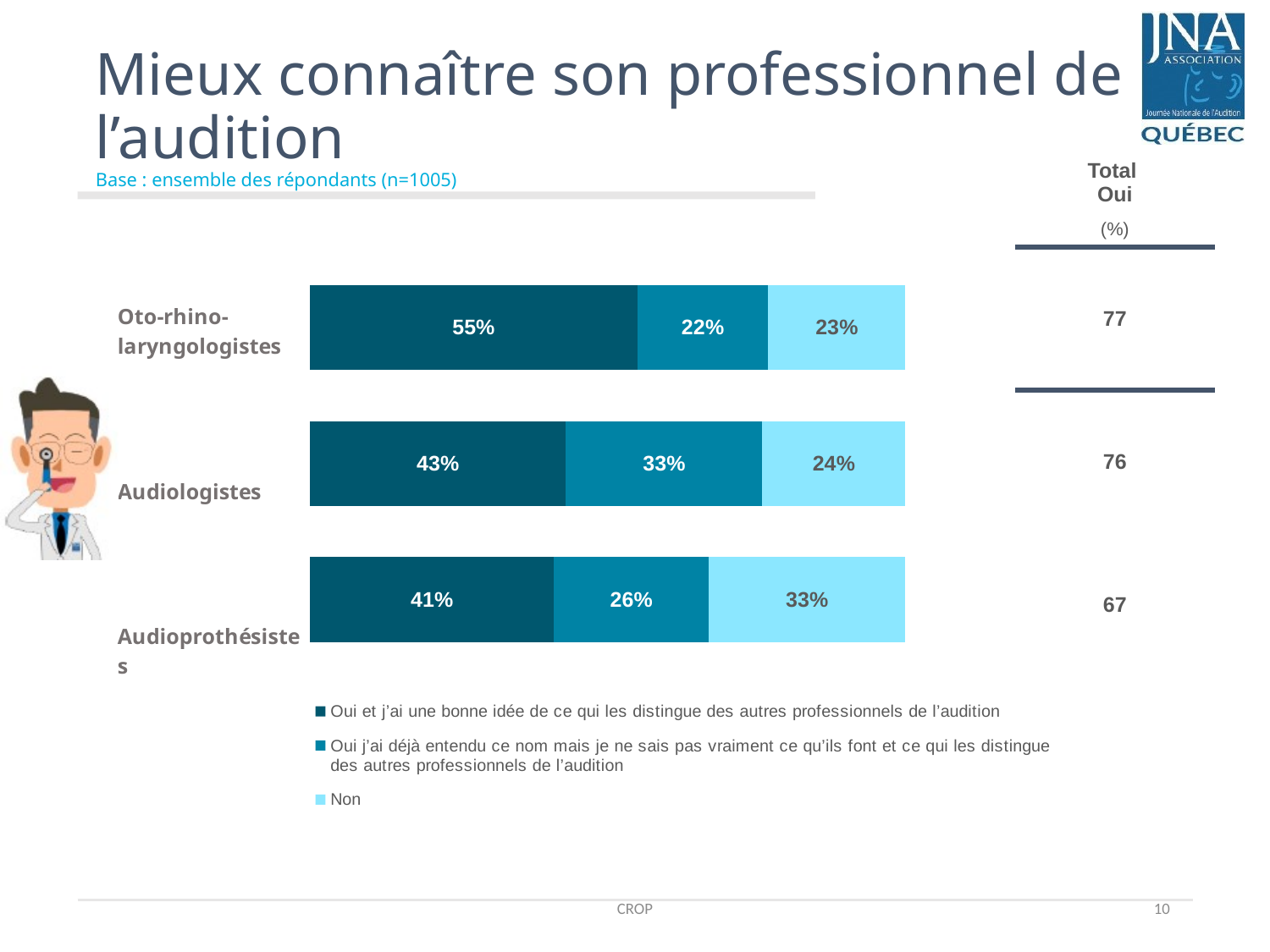
Which is larger: the "Oui j'ai déjà entendu ce nom..." share for Audiologistes or for Oto-rhino-laryngologistes? Audiologistes What percentage of respondents answered "Non" for Audiologistes? 24% What is the difference between the "Non" share for Audioprothésistes and for Oto-rhino-laryngologistes? 10 percentage points What is the "Total Oui" value shown for Audiologistes? 76 How many series does the legend list? 3 What percentage of respondents said "Oui et j'ai une bonne idée de ce qui les distingue des autres professionnels de l'audition" for Oto-rhino-laryngologistes? 55% What percentage of respondents answered "Oui j'ai déjà entendu ce nom mais je ne sais pas vraiment ce qu'ils font..." for Audioprothésistes? 26% What kind of chart is shown on the slide? Stacked bar chart Which professional category has the highest share of "Non" responses? Audioprothésistes Which professional category has the lowest share of "Oui et j'ai une bonne idée de ce qui les distingue..." responses? Audioprothésistes How many professional categories are shown in the chart? 3 What is the base (number of respondents) stated under the slide title? n=1005